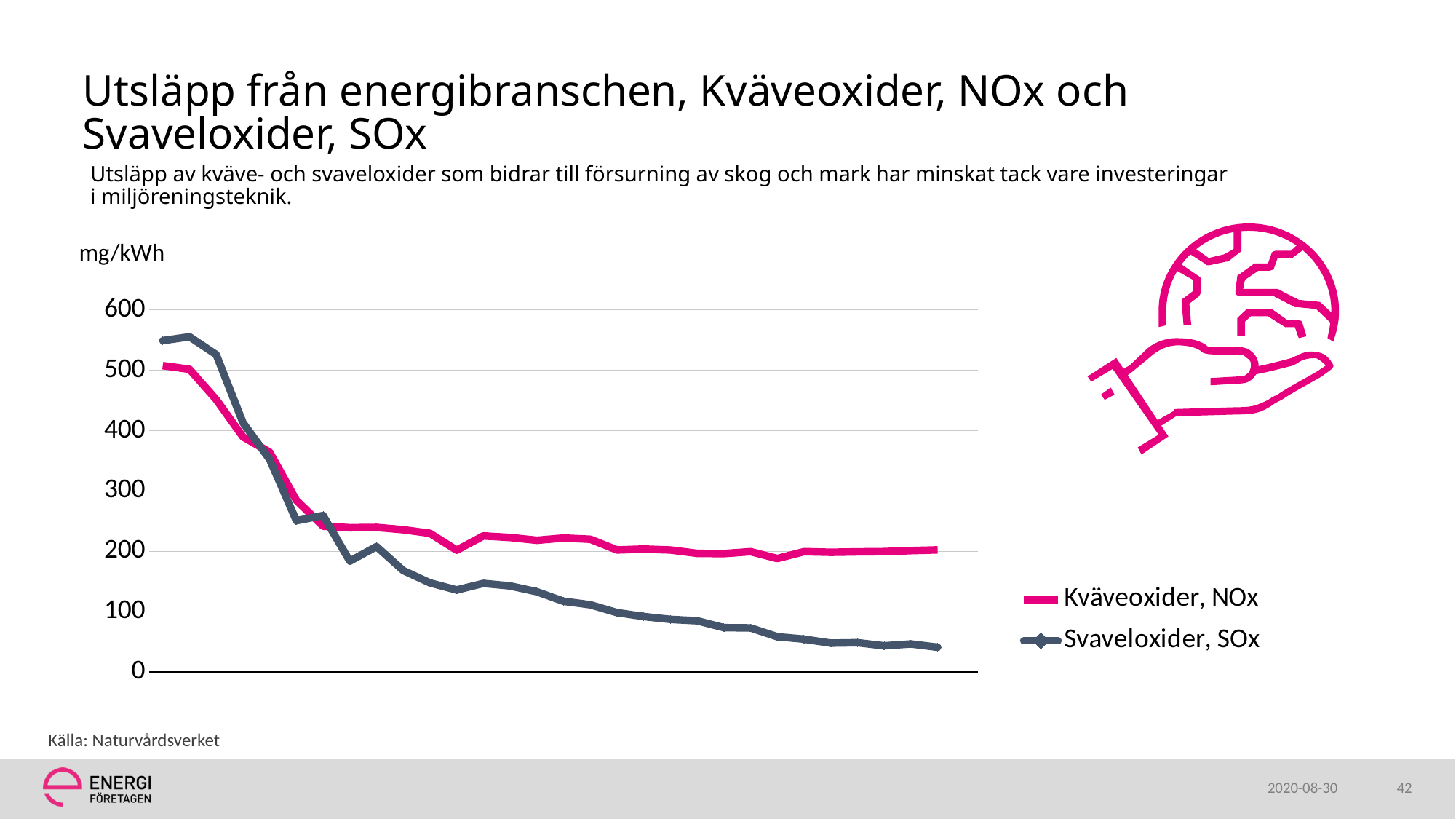
How many series does the legend list? 2 Do the values for Kväveoxider, NOx rise or fall along the x axis overall? fall Is the final value for Kväveoxider, NOx greater or less than 100? greater Is the final value for Svaveloxider, SOx greater or less than 100? less What unit is shown on the y axis of the chart? mg/kWh Do the values for Svaveloxider, SOx rise or fall along the x axis overall? fall Is the first value for Svaveloxider, SOx greater or less than 500? greater What kind of chart is shown on the slide? line chart What are the two series named in the legend? Kväveoxider, NOx and Svaveloxider, SOx At the right end of the chart, which series has the higher value, Kväveoxider, NOx or Svaveloxider, SOx? Kväveoxider, NOx At the left end of the chart, which series has the higher value, Kväveoxider, NOx or Svaveloxider, SOx? Svaveloxider, SOx